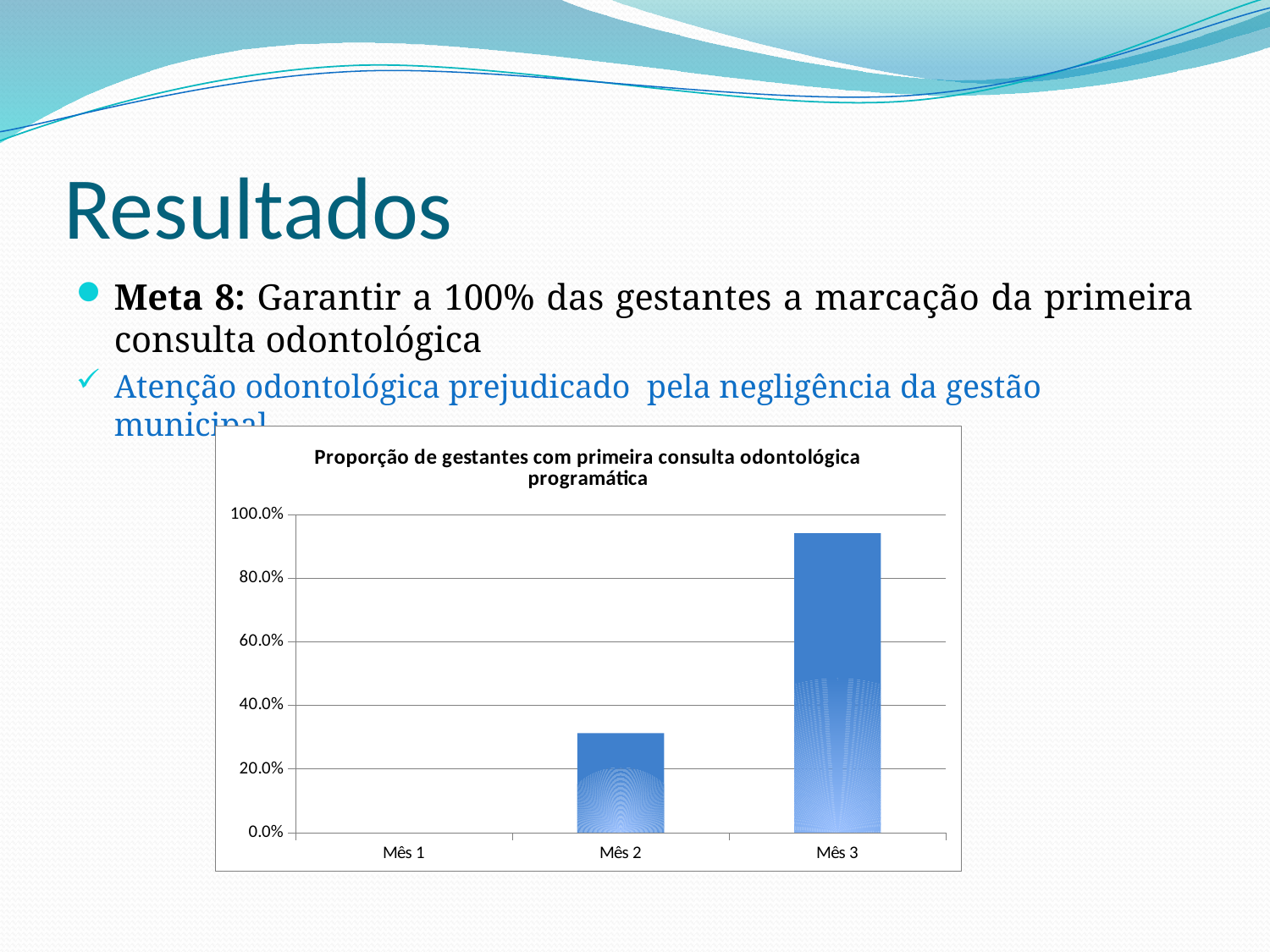
Is the value for Mês 3 greater or less than 80.0%? greater Which month has the highest proportion in the chart? Mês 3 How many categories are shown on the x axis of the chart? 3 What kind of chart is shown on the slide? bar chart Is the value for Mês 2 greater or less than 40.0%? less Do the values rise or fall from Mês 1 to Mês 3? rise Is the value for Mês 2 greater or less than 20.0%? greater Which month has the lowest proportion in the chart? Mês 1 What is the title of the chart? Proporção de gestantes com primeira consulta odontológica programática Which is larger, the value for Mês 2 or the value for Mês 3? Mês 3 What is the highest value shown on the y axis of the chart? 100.0%